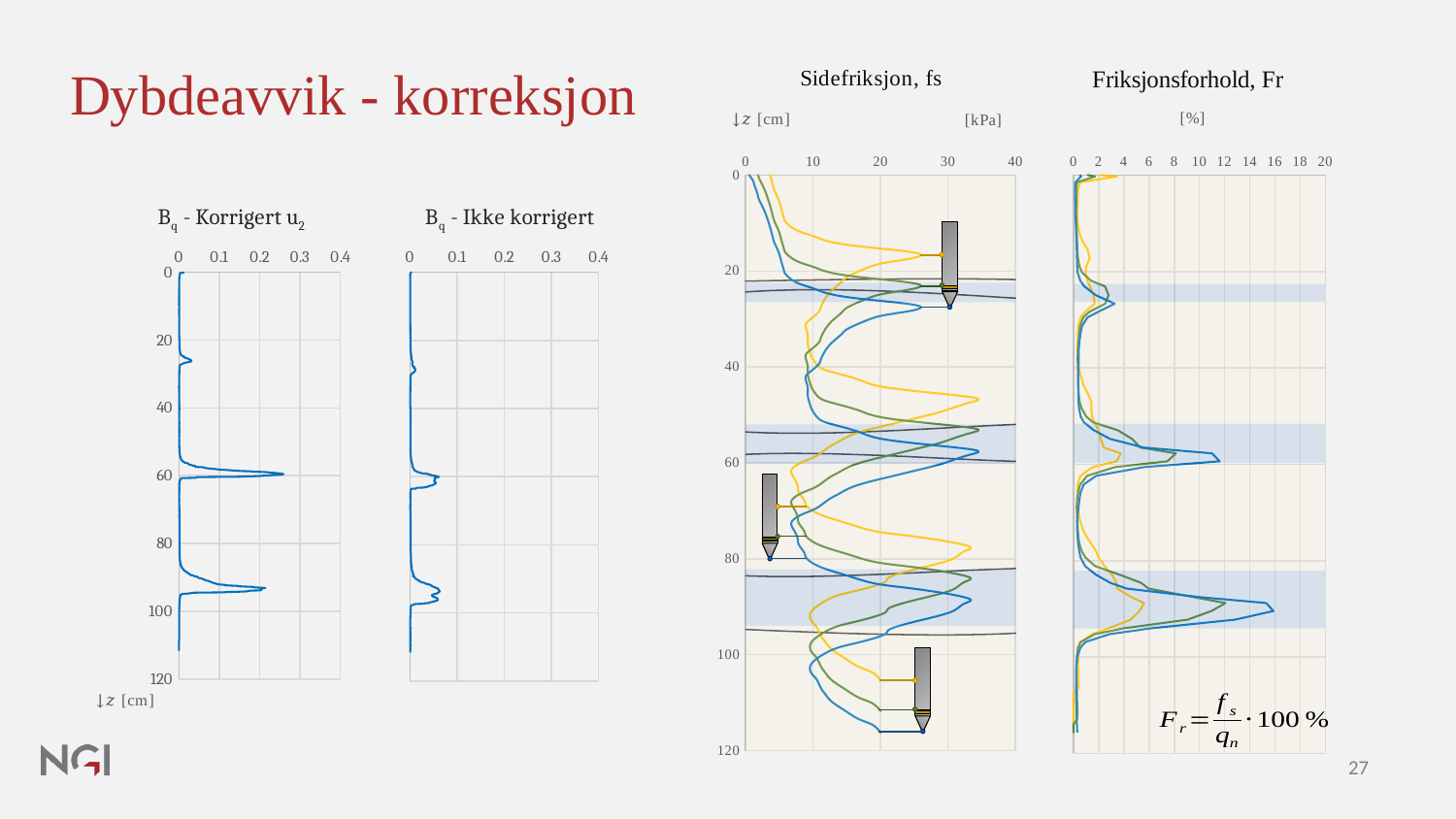
What kind of chart is the 'Bq - Korrigert u2' chart? line chart In the 'Sidefriksjon, fs' chart, is the blue line's value at a depth of 0 cm greater or less than 10? less In the 'Bq - Korrigert u2' chart, is the peak value near a depth of 60 cm greater or less than 0.2? greater How many lines are plotted in the 'Sidefriksjon, fs' chart? 3 What is the maximum value shown on the horizontal axis of the 'Friksjonsforhold, Fr' chart? 20 In the 'Bq - Ikke korrigert' chart, is the peak value near a depth of 60 cm greater or less than 0.1? less What unit is shown for the horizontal axis of the 'Sidefriksjon, fs' chart? kPa Which chart shows the larger peak near a depth of 60 cm, 'Bq - Korrigert u2' or 'Bq - Ikke korrigert'? Bq - Korrigert u2